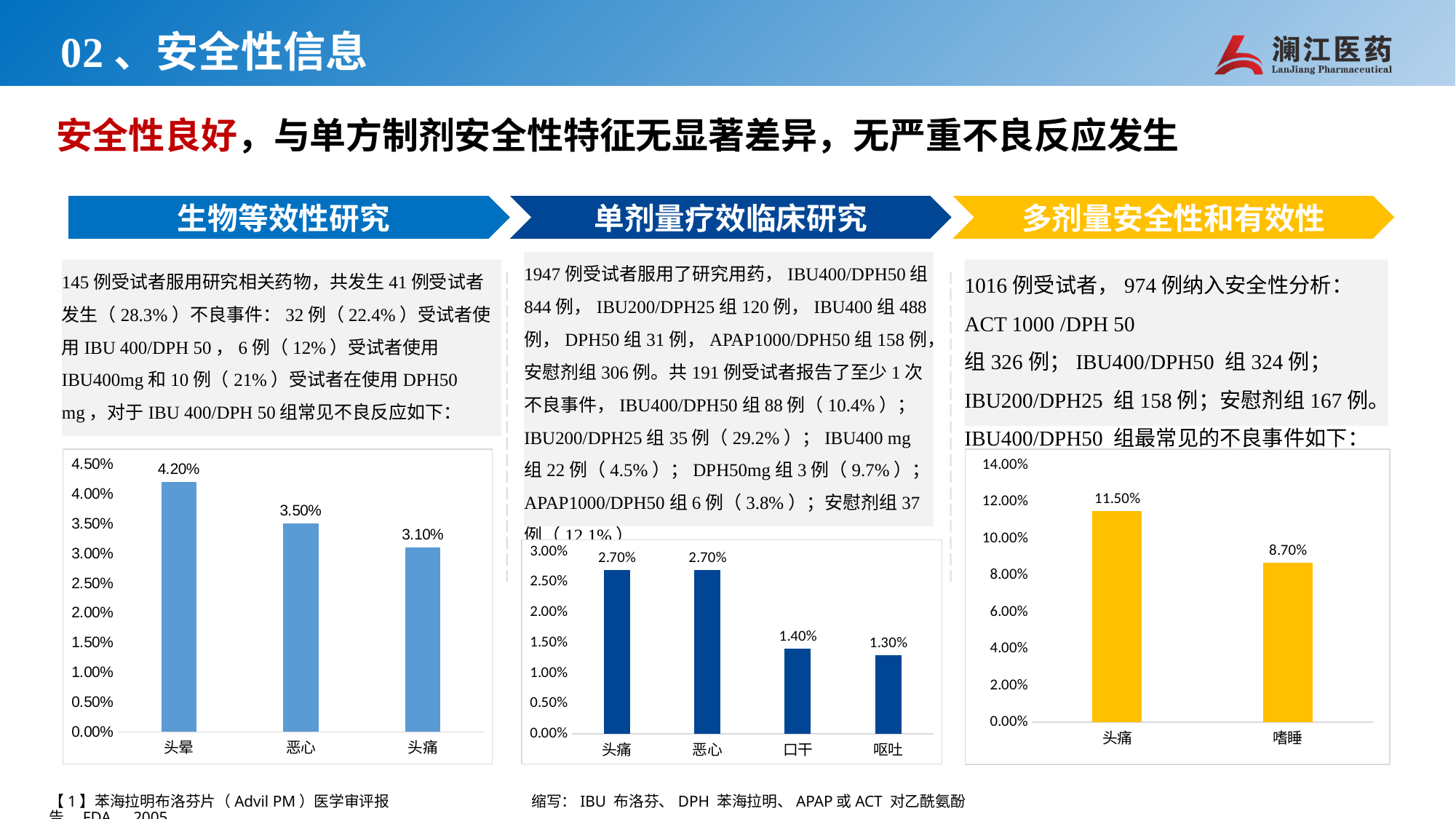
In the middle chart, how many categories are shown? 4 In the left chart, what is the value for 头晕? 4.20% In the middle chart, is the value for 恶心 larger or smaller than the value for 呕吐? larger In the right chart, what is the difference between the values for 头痛 and 嗜睡? 2.80% In the middle chart, what is the value for 口干? 1.40% In the right chart, which category has the highest value? 头痛 In the left chart, which category has the lowest value? 头痛 In the left chart, how many categories are shown? 3 In the middle chart, which category has the lowest value? 呕吐 In the right chart, what is the value for 嗜睡? 8.70% In the left chart, what is the difference between the values for 头晕 and 恶心? 0.70% What type of chart is the right chart? bar chart